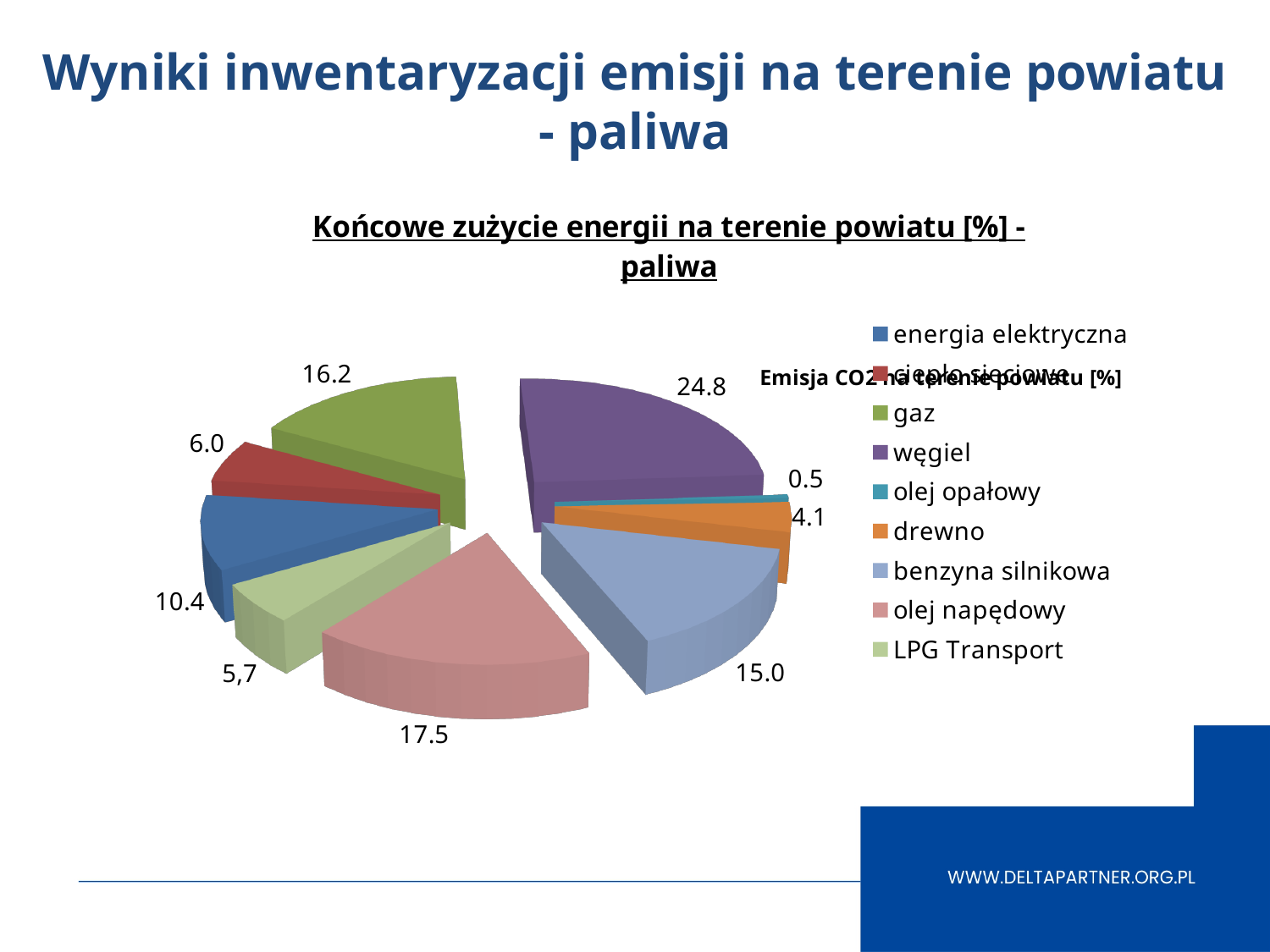
What is the difference between the values for węgiel and olej napędowy? 7.3 What value is shown for gaz in the pie chart? 16.2 What is the title of the pie chart? Końcowe zużycie energii na terenie powiatu [%] - paliwa Which category has the largest slice of the pie chart? węgiel What value is shown for węgiel in the pie chart? 24.8 What value is shown for energia elektryczna in the pie chart? 10.4 How many categories does the legend of the pie chart list? 9 Which category has the smallest slice of the pie chart? olej opałowy What value is shown for olej napędowy in the pie chart? 17.5 What value is shown for benzyna silnikowa in the pie chart? 15.0 What kind of chart is shown on the slide? pie chart Which is larger in the pie chart, the value for drewno or the value for LPG Transport? LPG Transport